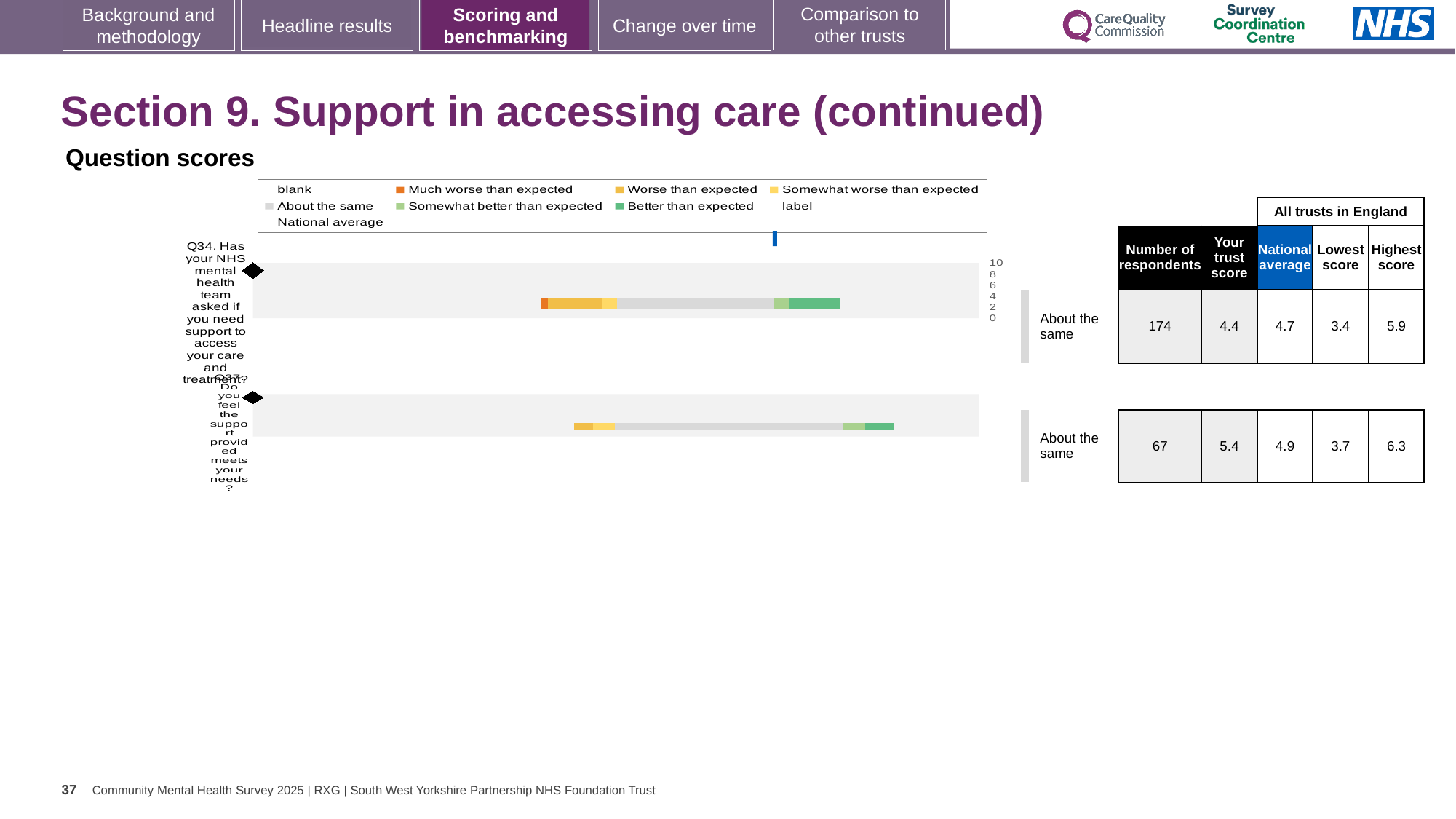
What is the highest score among all trusts in England for Q37? 6.3 What is the number of respondents for Q34? 174 In the legend of the question scores chart, what colour represents 'Much worse than expected'? orange What is the highest value shown on the score axis of the question scores chart? 10 What is the difference between the highest score and the lowest score for Q34? 2.5 For Q37, which is larger: the trust score or the national average? trust score What benchmark category is shown for Q34? About the same What is the trust score for Q34? 4.4 In the legend of the question scores chart, what colour represents 'Better than expected'? green What is the national average for Q37? 4.9 What kind of chart is used to show the question scores? bar chart How many questions (bars) are plotted in the question scores chart? 2